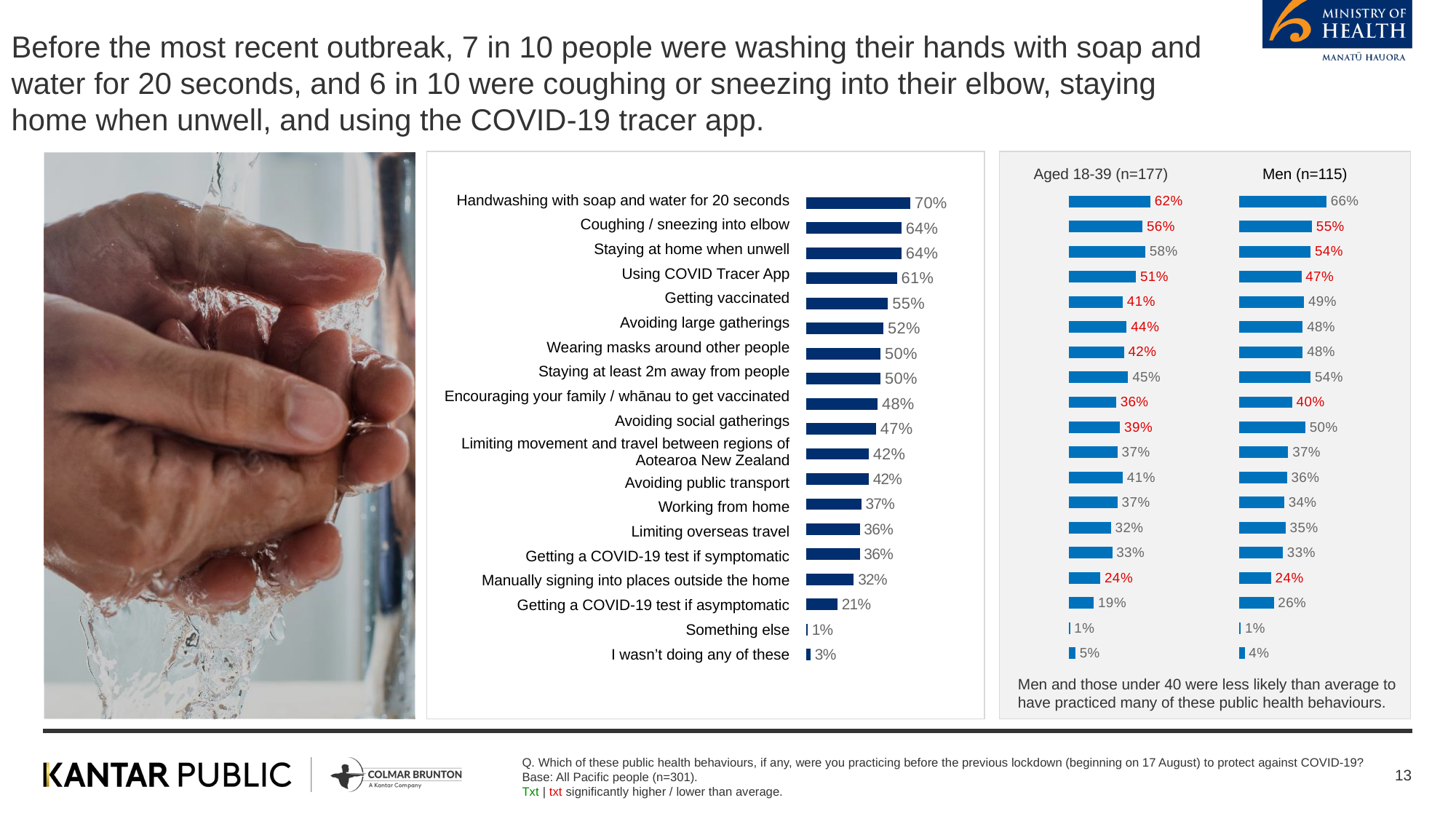
In the main chart (all Pacific people), what percentage were handwashing with soap and water for 20 seconds? 70% In the Men (n=115) chart, what is the difference between Handwashing with soap and water for 20 seconds and Coughing / sneezing into elbow? 11 percentage points In the Aged 18-39 (n=177) chart, what percentage were using the COVID Tracer App? 51% In the Men (n=115) chart, what percentage were staying at least 2m away from people? 54% In the main chart (all Pacific people), which behaviour has the lowest percentage? Something else What is the sample size shown for the Men chart? n=115 What type of chart is used to show the public health behaviours on this slide? Bar chart Which is larger for Getting vaccinated: the Aged 18-39 chart or the Men chart? Men In the Aged 18-39 (n=177) chart, what percentage said 'I wasn't doing any of these'? 5% In the main chart (all Pacific people), what is the difference between Getting vaccinated and Getting a COVID-19 test if asymptomatic? 34 percentage points In the main chart (all Pacific people), which behaviour has the highest percentage? Handwashing with soap and water for 20 seconds In the main chart (all Pacific people), how many behaviour categories are listed? 19